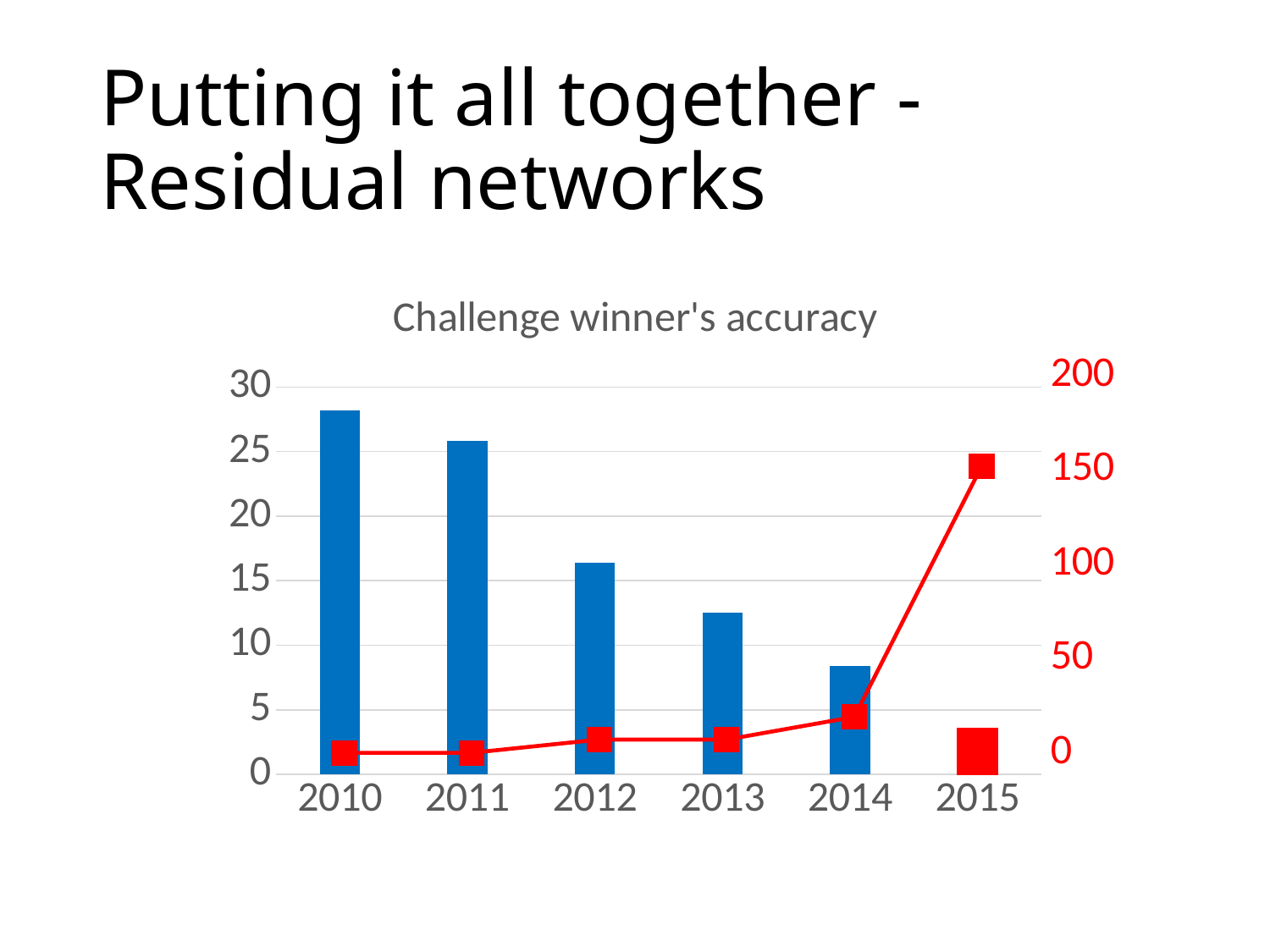
Do the bar values rise or fall from 2010 to 2015? fall What kind of chart is shown on the slide? A bar chart combined with a line chart Is the bar value for 2013 greater or less than 15 on the left axis? less Is the red line value for 2015 greater or less than 100 on the right axis? greater How many years are shown on the x axis of the chart? 6 Which year has the tallest bar in the chart? 2010 Which year has the highest value on the red line (right axis)? 2015 Is the bar value for 2010 greater or less than 25 on the left axis? greater Which bar is taller, 2011 or 2012? 2011 What is the title of the chart? Challenge winner's accuracy